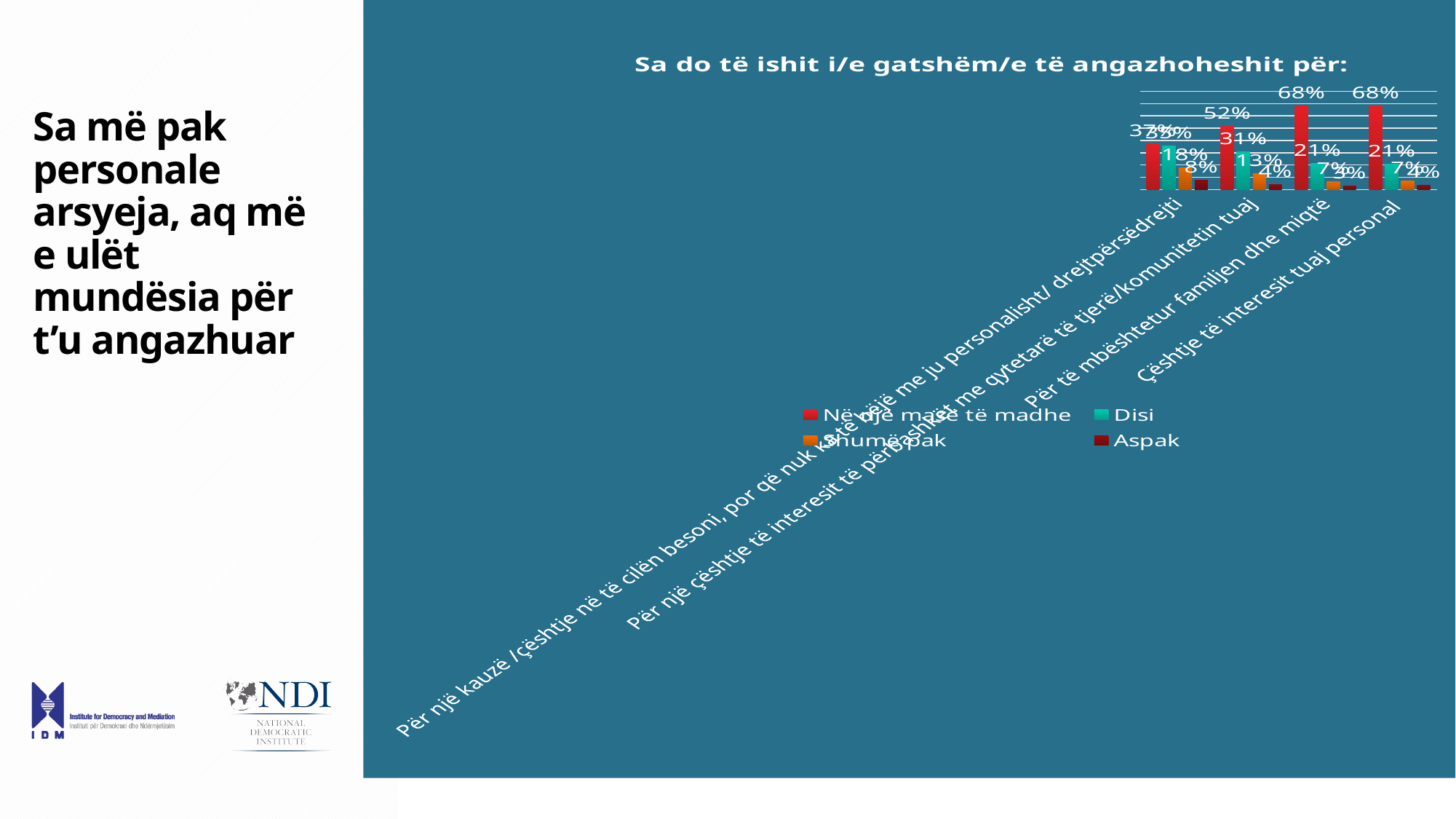
How many series does the chart legend list? 4 What kind of chart is shown on the slide? bar chart Which is larger: 'Disi' for 'Për një çështje të interesit të përbashkët me qytetarë të tjerë/komunitetin tuaj' or 'Disi' for 'Për të mbështetur familjen dhe miqtë'? Për një çështje të interesit të përbashkët me qytetarë të tjerë/komunitetin tuaj What is the value of 'Disi' for 'Për një çështje të interesit të përbashkët me qytetarë të tjerë/komunitetin tuaj'? 31% How many categories are plotted along the x axis of the chart? 4 What is the value of 'Aspak' for 'Për të mbështetur familjen dhe miqtë'? 3% What is the value of 'Në një masë të madhe' for 'Për të mbështetur familjen dhe miqtë'? 68% What is the value of 'Disi' for 'Çështje të interesit tuaj personal'? 21% What is the value of 'Në një masë të madhe' for 'Për një çështje të interesit të përbashkët me qytetarë të tjerë/komunitetin tuaj'? 52% For 'Për të mbështetur familjen dhe miqtë', what is the difference between 'Në një masë të madhe' and 'Disi'? 47 percentage points What is the value of 'Shumë pak' for 'Për të mbështetur familjen dhe miqtë'? 7% What is the title of the chart? Sa do të ishit i/e gatshëm/e të angazhoheshit për: